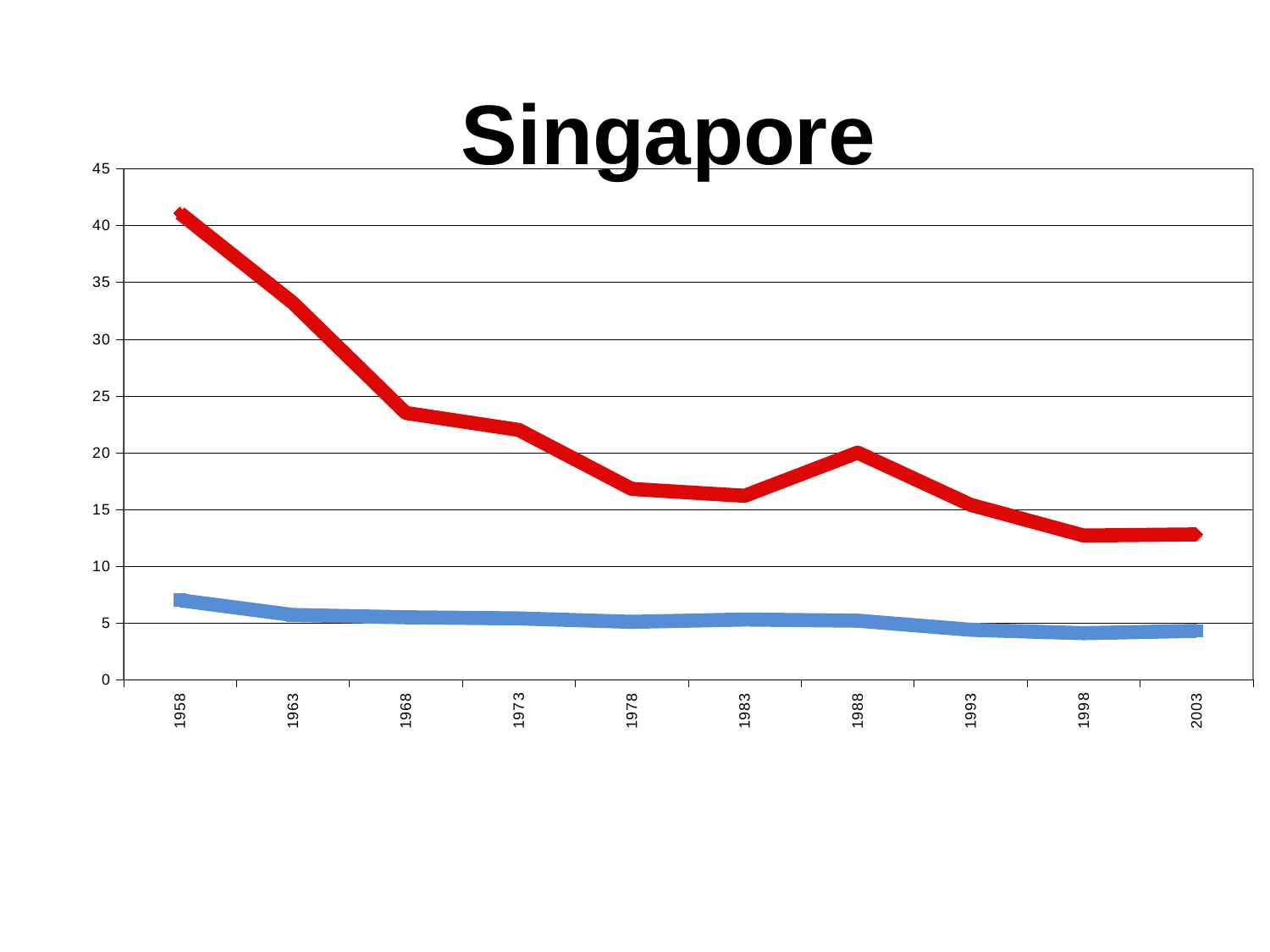
In which year is the red line at its highest value? 1958 Is the value of the red line in 1968 greater or less than 25? less What type of chart is shown on the slide? line chart What is the title of the chart? Singapore Is the value of the red line in 1963 greater or less than 35? less Does the red line generally rise or fall from 1958 to 2003? fall How many years are labelled on the x axis? 10 In 1988, which line has the larger value, the red line or the blue line? red line Is the value of the blue line in 1958 greater or less than 5? greater In which year is the blue line at its highest value? 1958 How many lines are plotted on the chart? 2